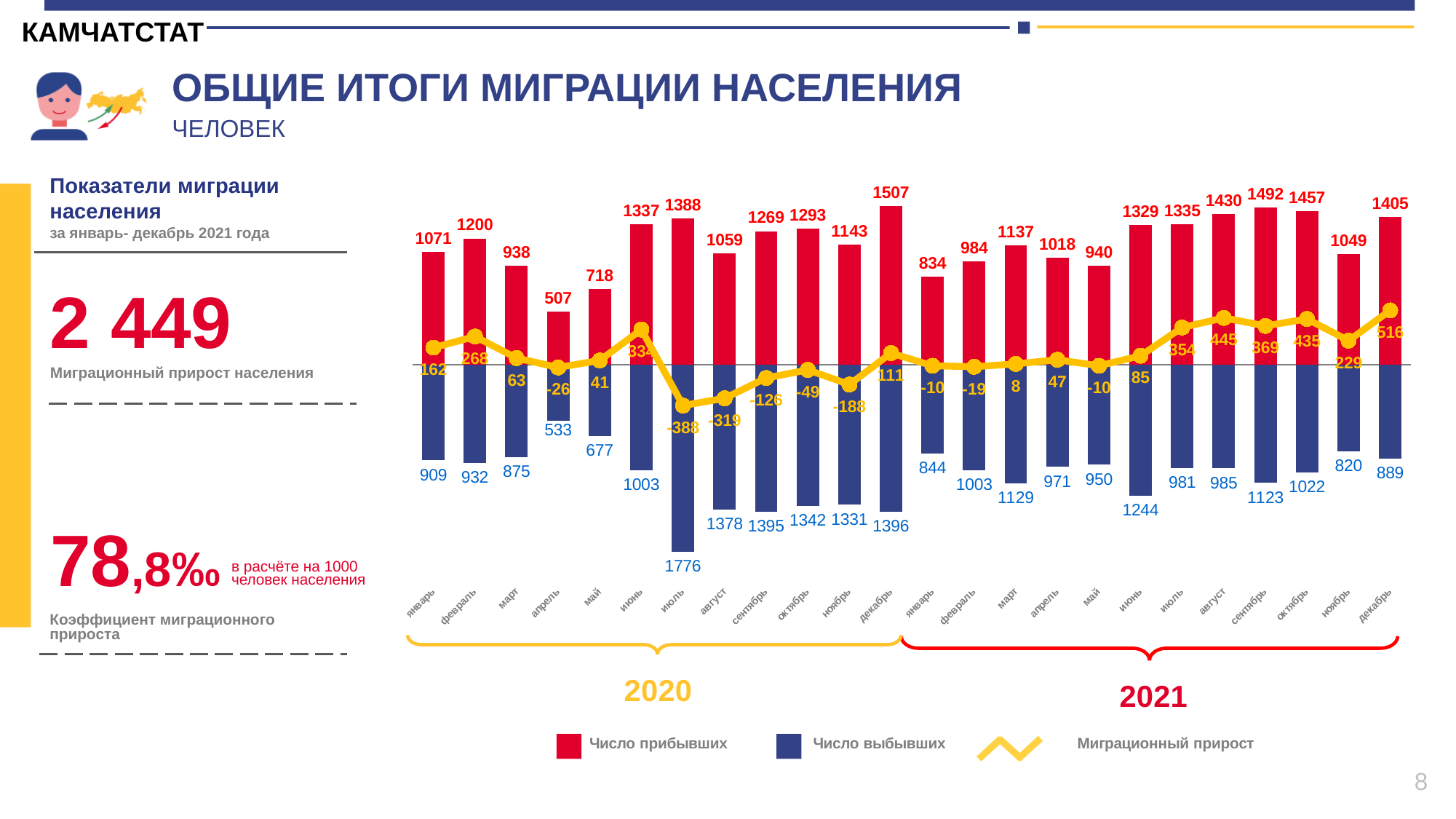
How many months are shown on the x axis of the chart? 24 In which month is the number of arrivals highest across the whole chart? декабрь 2020 Which is larger in June 2021: the number of arrivals or the number of departures? arrivals (1329) How many series does the legend list? 3 In which month is the net migration (Миграционный прирост) lowest? июль 2020 What kind of chart is shown on the slide? combined bar and line chart What is the number of departures (Число выбывших) in July 2020? 1776 What is the number of arrivals (Число прибывших) in December 2021? 1405 In which month is the number of arrivals lowest across the whole chart? апрель 2020 What is the difference between arrivals and departures in September 2021? 369 Which colour represents the number of departures (Число выбывших) in the chart? blue What is the net migration (Миграционный прирост) value for August 2021? 445